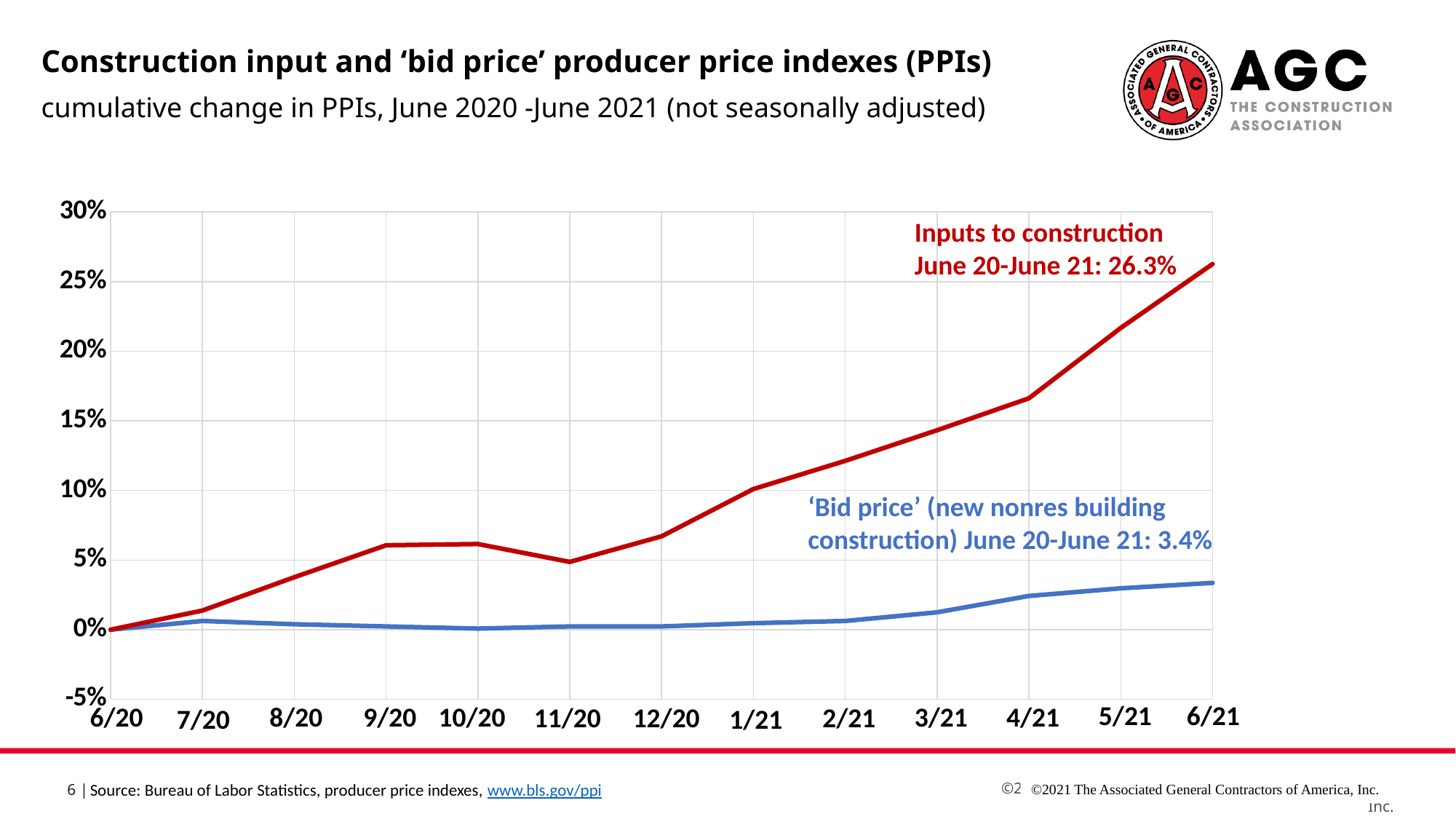
What is the cumulative change in the 'Bid price' (new nonres building construction) PPI from June 2020 to June 2021? 3.4% Is the value for 'Bid price' at 6/21 greater or less than 5%? less How many monthly points are shown along the x axis? 13 Which series shows the larger cumulative change from June 2020 to June 2021, 'Inputs to construction' or 'Bid price'? Inputs to construction Does the 'Inputs to construction' line generally rise or fall from 12/20 to 6/21? rise What is the cumulative change in the 'Inputs to construction' PPI from June 2020 to June 2021? 26.3% Is the value for 'Inputs to construction' at 9/20 greater or less than 10%? less What colour is the line for 'Inputs to construction'? red How many series are plotted on the chart? 2 What is the difference between the June 20-June 21 cumulative change for 'Inputs to construction' and for 'Bid price'? 22.9 percentage points What kind of chart is shown on the slide? line chart Is the value for 'Inputs to construction' at 4/21 greater or less than 15%? greater